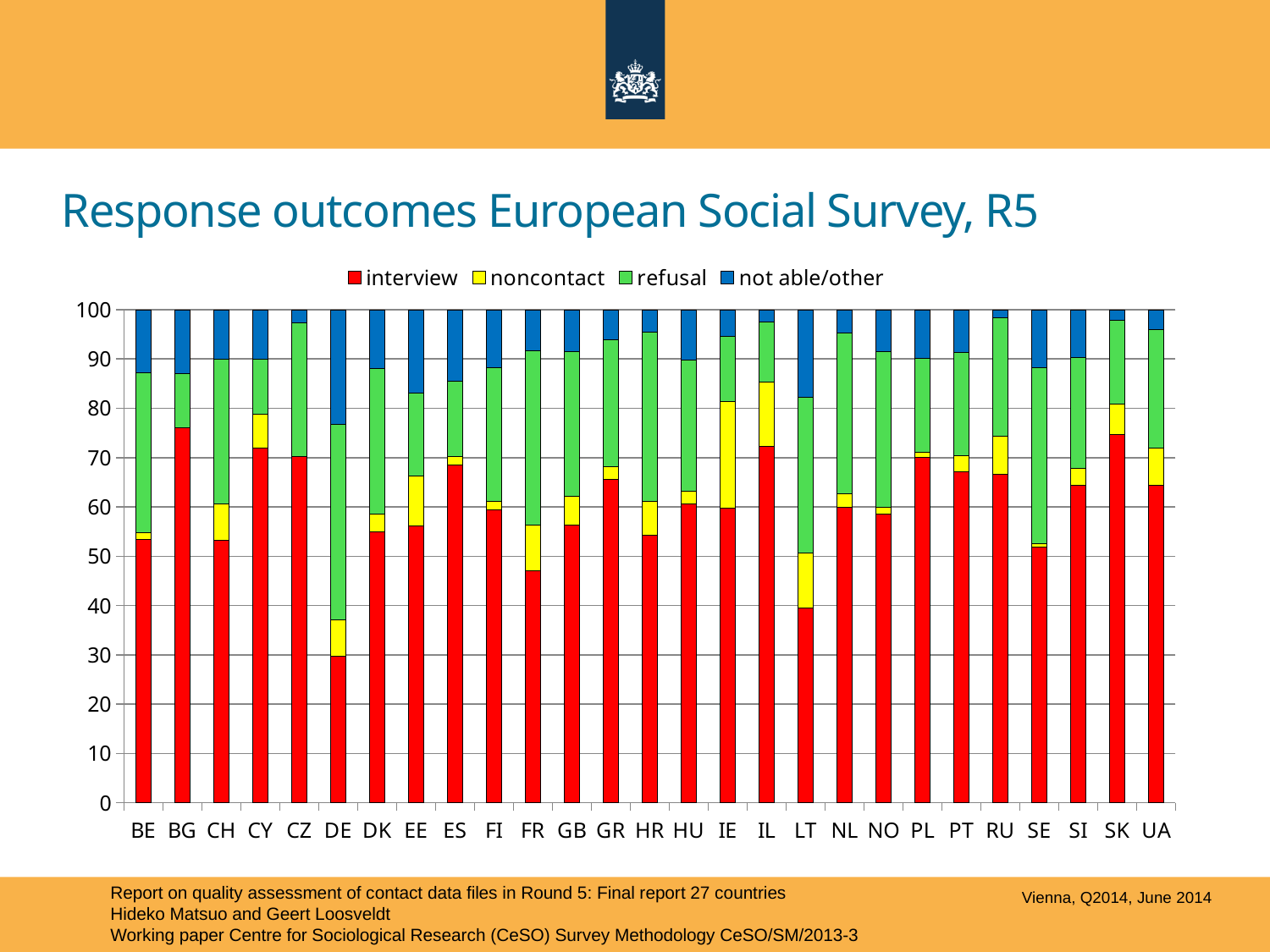
Is the interview value for BG greater or less than 70? greater Is the interview value for DE greater or less than 40? less What kind of chart is shown on the slide? stacked bar chart Which series is shown in red in the legend? interview Which country has the lowest interview value? DE What is the title of the chart? Response outcomes European Social Survey, R5 How many series does the legend list? 4 Which has the larger interview value, DE or BG? BG Is the interview value for LT greater or less than 50? less Which has the larger interview value, LT or CZ? CZ How many countries (categories) are shown along the x axis? 27